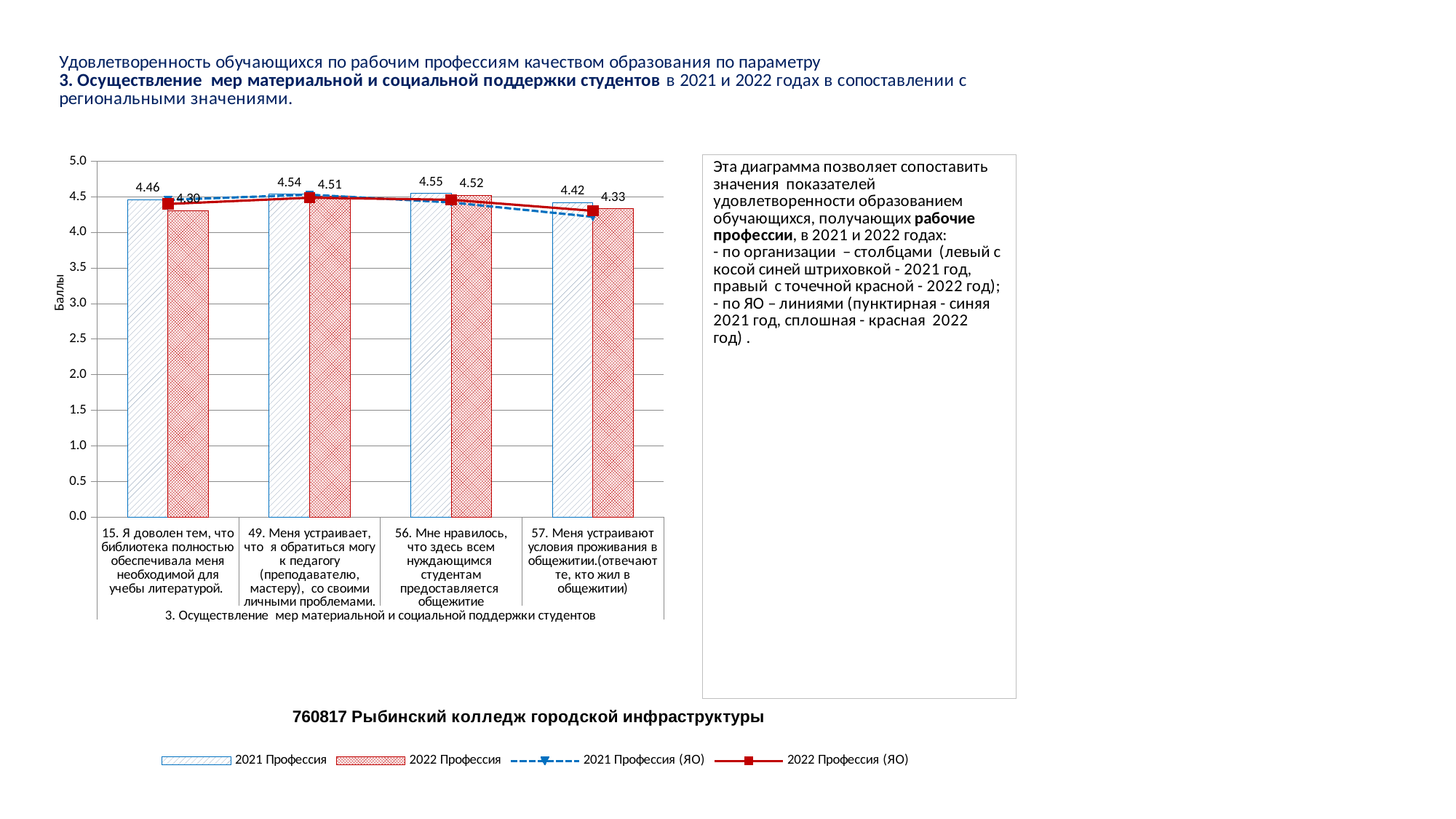
What is the difference between the 2021 Профессия and 2022 Профессия values for item 15? 0.16 What is the value of the 2021 Профессия bar for item 15 (Я доволен тем, что библиотека полностью обеспечивала меня необходимой для учебы литературой)? 4.46 What is the value of the 2022 Профессия bar for item 57 (Меня устраивают условия проживания в общежитии)? 4.33 How many categories are shown on the x axis of the chart? 4 What is the value of the 2022 Профессия bar for item 49 (Меня устраивает, что я обратиться могу к педагогу)? 4.51 What is the label of the y axis of the chart? Баллы Is the 2021 Профессия (ЯО) line value for item 57 greater or less than 4.5? less Which category has the lowest 2022 Профессия bar? 15. Я доволен тем, что библиотека полностью обеспечивала меня необходимой для учебы литературой Which category has the highest 2021 Профессия bar? 56. Мне нравилось, что здесь всем нуждающимся студентам предоставляется общежитие How many series does the chart legend list? 4 What is the difference between the 2021 Профессия and 2022 Профессия values for item 57? 0.09 For item 56, which is larger: the 2021 Профессия bar or the 2022 Профессия bar? 2021 Профессия